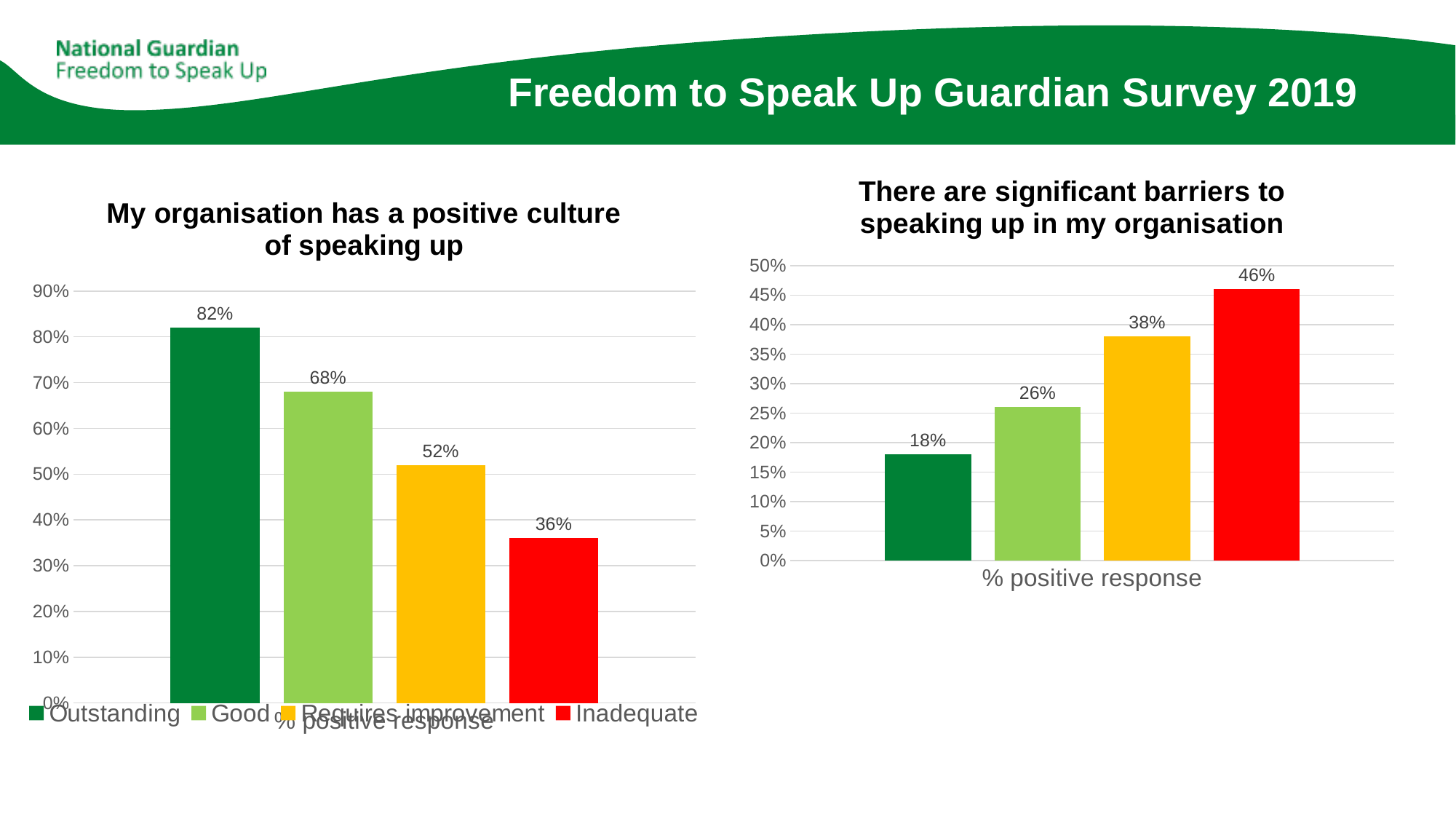
In the chart titled 'My organisation has a positive culture of speaking up', what is the value for Inadequate? 36% What kind of chart is the chart titled 'There are significant barriers to speaking up in my organisation'? Bar chart In the chart titled 'My organisation has a positive culture of speaking up', which series has the highest value? Outstanding In the chart titled 'There are significant barriers to speaking up in my organisation', what is the value for Requires improvement? 38% In the chart titled 'There are significant barriers to speaking up in my organisation', which series has the lowest value? Outstanding In the chart titled 'My organisation has a positive culture of speaking up', what is the value for Outstanding? 82% In the chart titled 'My organisation has a positive culture of speaking up', what colour is the Inadequate bar? Red In the chart titled 'My organisation has a positive culture of speaking up', what is the difference between the Outstanding and Good values? 14% In the chart titled 'There are significant barriers to speaking up in my organisation', which is larger, the value for Good or the value for Requires improvement? Requires improvement In the chart titled 'There are significant barriers to speaking up in my organisation', what is the difference between the Inadequate and Outstanding values? 28% In the chart titled 'There are significant barriers to speaking up in my organisation', what is the value for Good? 26% How many series does the legend on the left chart list? 4